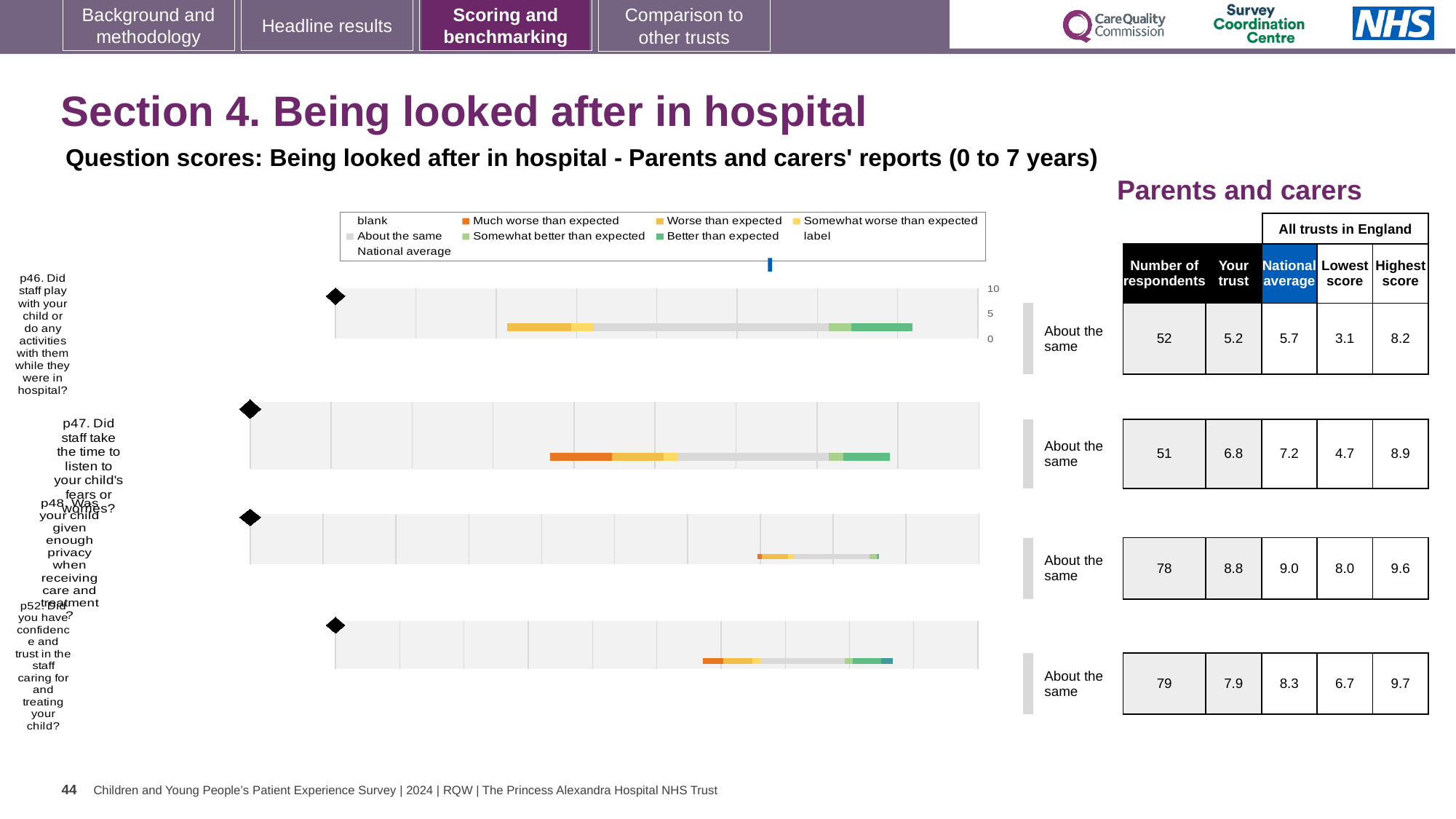
What benchmark category is shown next to the p46 chart? About the same Which question has the highest 'Your trust' score? p48 For the p48 chart (Was your child given enough privacy...), what is the number of respondents? 78 How many entries does the legend above the charts list? 9 For the p52 chart (Did you have confidence and trust in the staff...), what is the difference between the Highest score and the Lowest score? 3.0 Which question has the lowest 'Your trust' score? p46 What is the highest value shown on the axis of the p46 chart? 10 How many question charts (p46, p47, p48, p52) are shown on the slide? 4 For the p47 chart (Did staff take the time to listen to your child's fears or worries?), what is the National average? 7.2 For the p47 chart, which is larger: the 'Your trust' score or the National average? National average For the p46 chart (Did staff play with your child...), what is the 'Your trust' score? 5.2 What kind of chart is used to show the question scores on this slide? bar chart